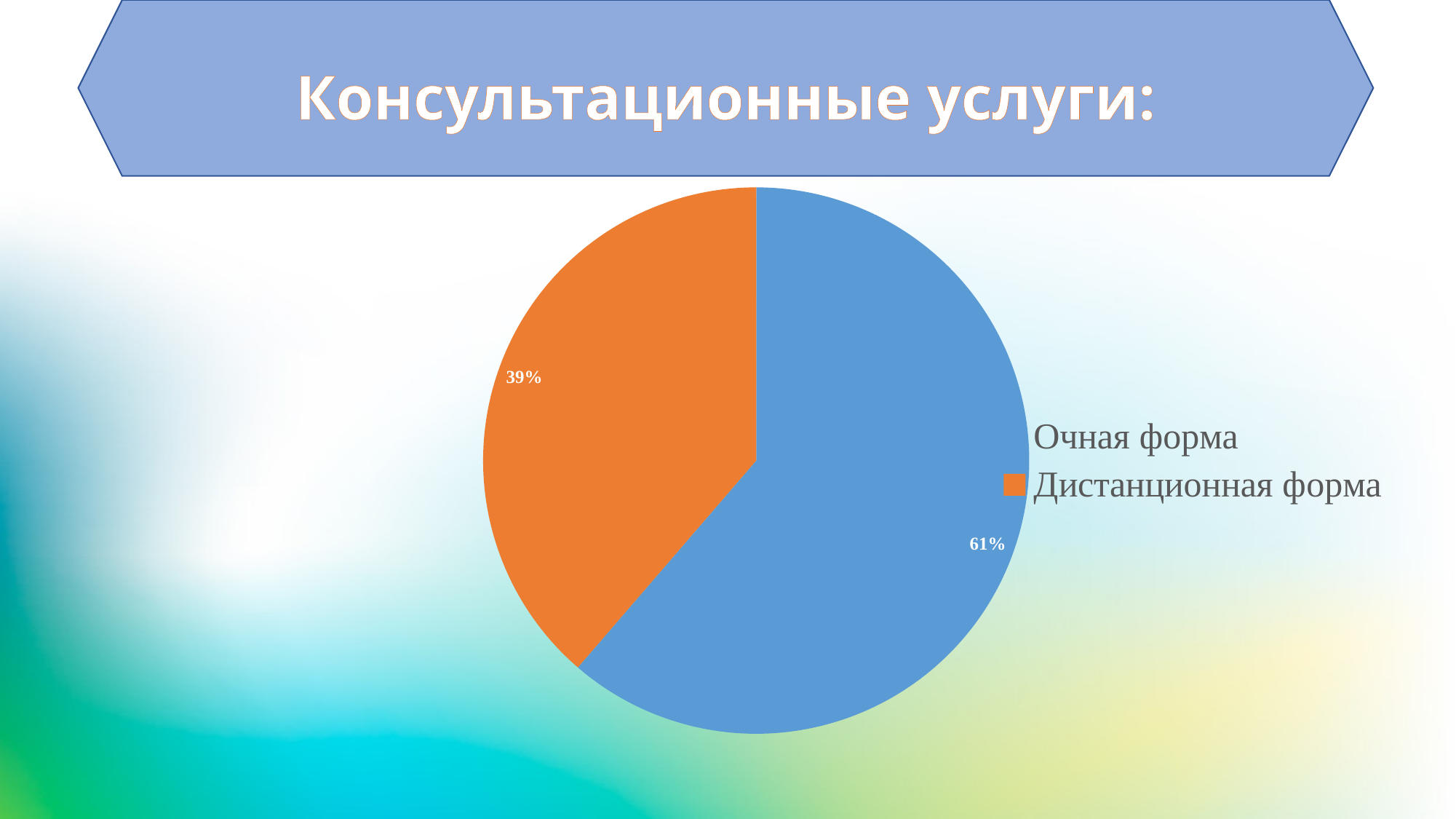
What colour is the slice for "Дистанционная форма"? orange What share of the pie does "Очная форма" have? 61% Which is larger: the slice for "Очная форма" or the slice for "Дистанционная форма"? Очная форма What share of the pie does "Дистанционная форма" have? 39% What kind of chart is shown on the slide? pie chart How many entries does the legend list? 2 How many slices does the pie chart have? 2 What is the title shown above the chart? Консультационные услуги: Which category has the largest slice of the pie? Очная форма What is the difference in percentage points between "Очная форма" and "Дистанционная форма"? 22 Which category has the smallest slice of the pie? Дистанционная форма